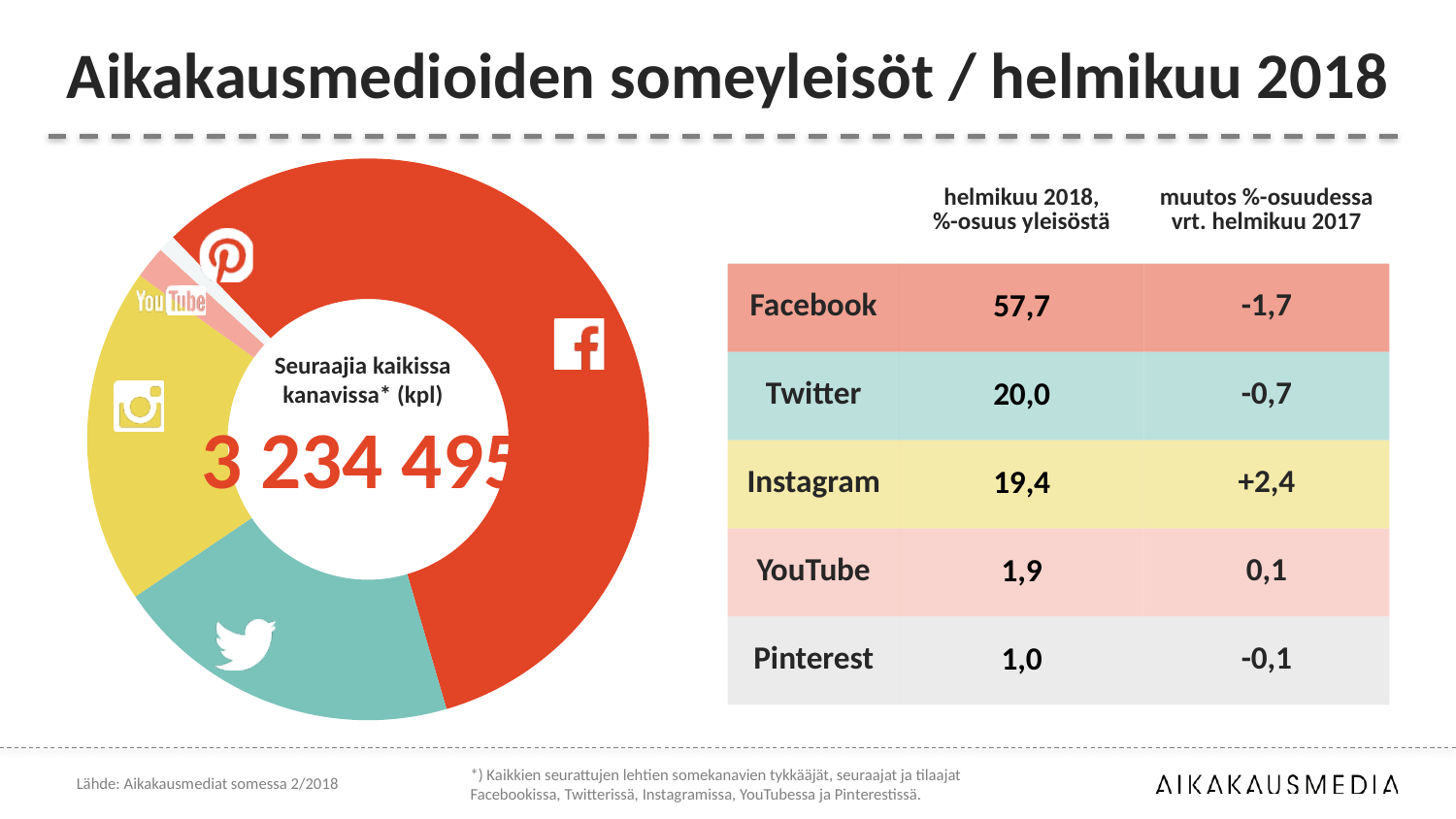
Which has a larger share of the audience in February 2018, Twitter or Instagram? Twitter What is the difference between Facebook's and Twitter's share of the audience in February 2018? 37,7 What is Instagram's share of the audience in February 2018? 19,4 Which channel has the smallest share of the audience in the donut chart? Pinterest What is Facebook's share of the audience in February 2018? 57,7 How many social media channels are shown as slices in the donut chart? 5 What is the change in Instagram's percentage share compared with February 2017? +2,4 What is the change in Facebook's percentage share compared with February 2017? -1,7 What is the title of the slide? Aikakausmedioiden someyleisöt / helmikuu 2018 What is the total number of followers across all channels shown in the centre of the donut chart? 3 234 495 What kind of chart is shown on the left of the slide? Pie chart (donut) Which channel has the largest share of the audience in the donut chart? Facebook